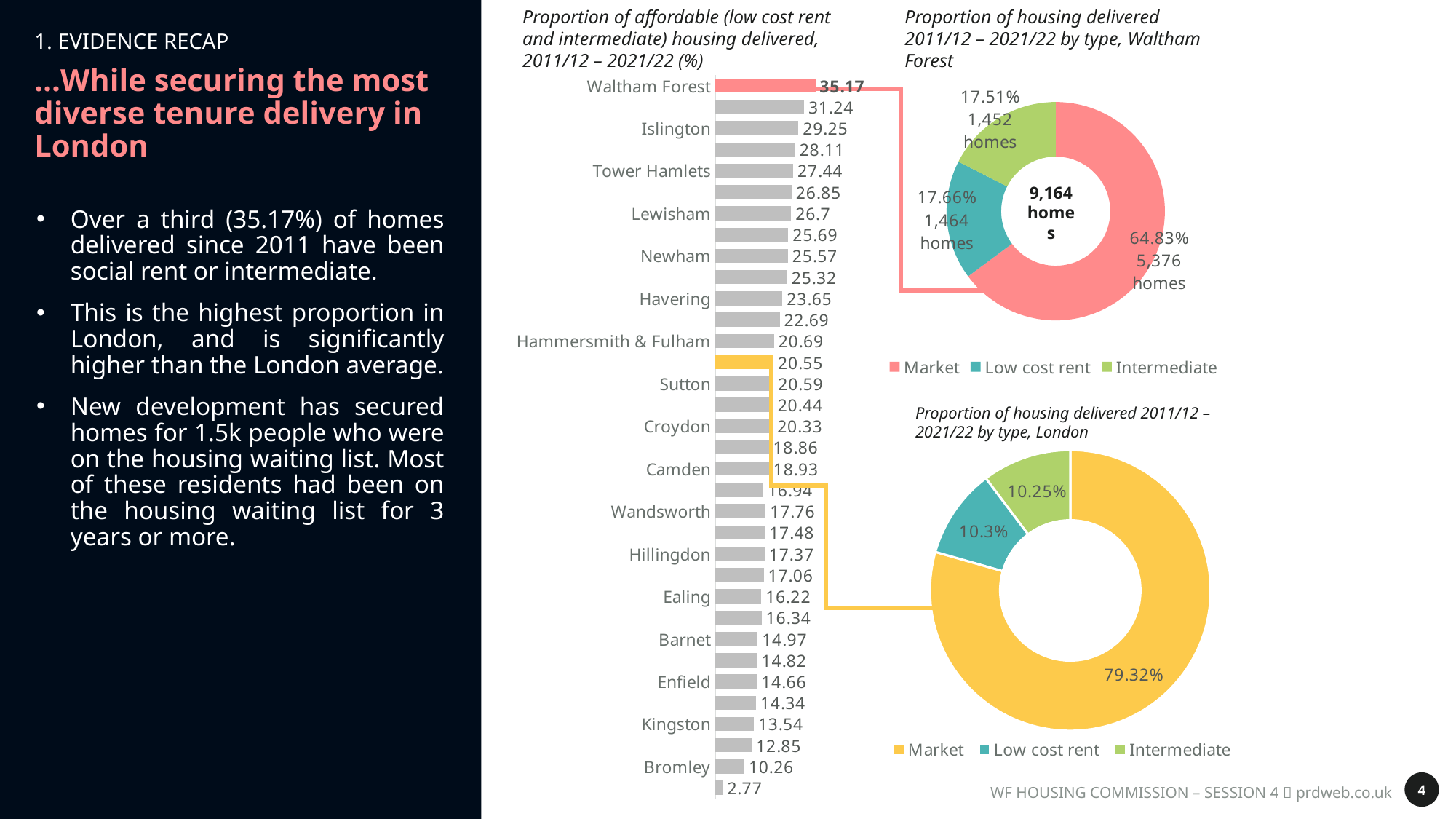
What type of chart is the chart of affordable housing delivered 2011/12 – 2021/22 by borough? Bar chart In the Waltham Forest housing by type chart, what is the total number of homes shown in the centre? 9,164 homes In the Waltham Forest housing by type chart, what percentage of homes delivered were Market? 64.83% In the Waltham Forest housing by type chart, how many Low cost rent homes were delivered? 1,464 homes In the bar chart of affordable housing delivered 2011/12 – 2021/22, what is the difference between Waltham Forest and Tower Hamlets? 7.73 In the bar chart of affordable housing delivered 2011/12 – 2021/22, what is the value for Bromley? 10.26 How many categories does the legend of the London housing by type chart list? 3 In the bar chart of affordable housing delivered 2011/12 – 2021/22, which is larger, Lewisham or Havering? Lewisham In the bar chart of affordable housing delivered 2011/12 – 2021/22, what is the value for Waltham Forest? 35.17 In the bar chart of affordable housing delivered 2011/12 – 2021/22, which borough has the highest value? Waltham Forest In the bar chart of affordable housing delivered 2011/12 – 2021/22, what is the value for Islington? 29.25 In the London housing by type chart, what percentage of homes delivered were Market? 79.32%